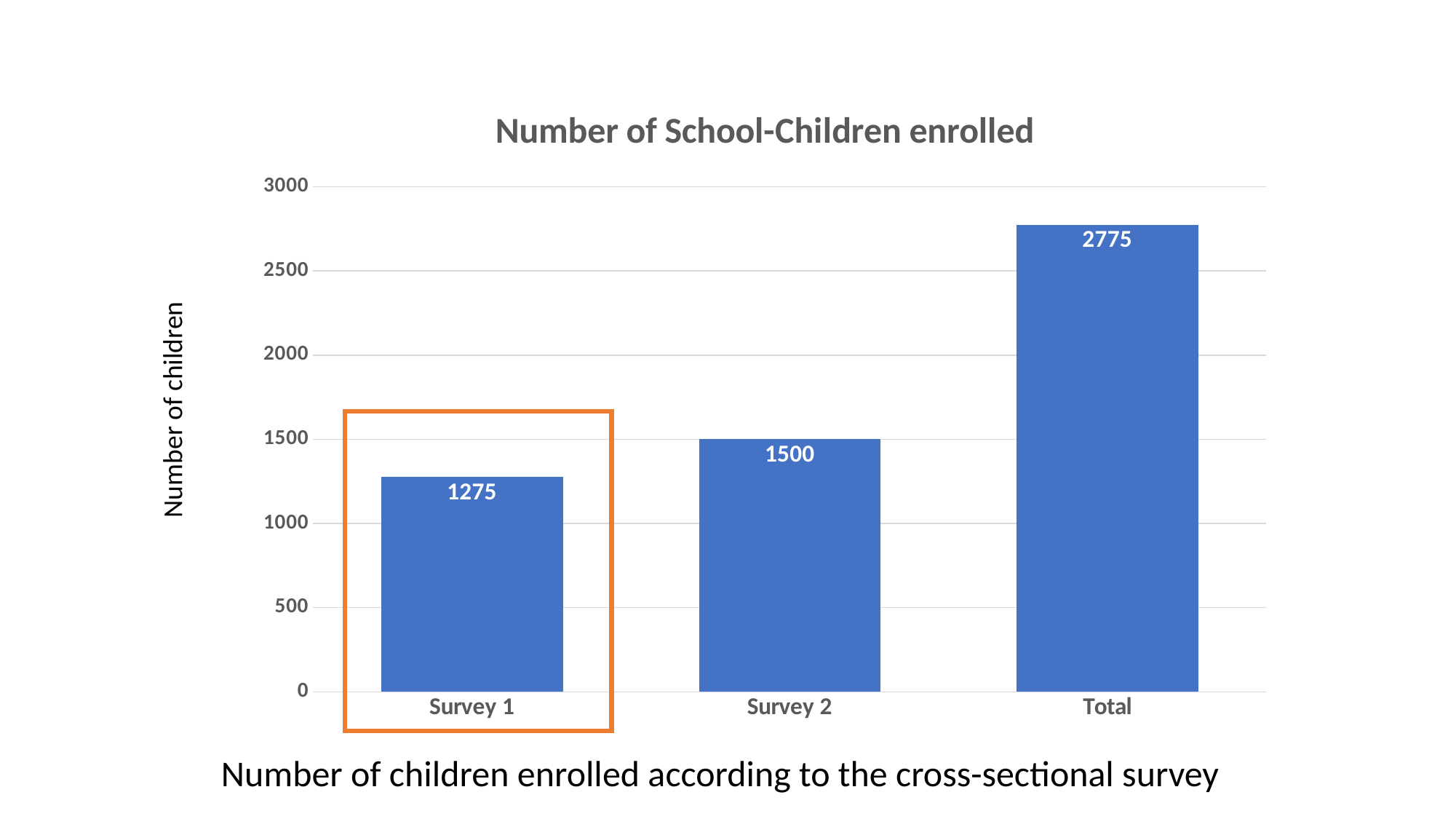
What is the difference between the values for Survey 2 and Survey 1? 225 What is the value for Survey 1? 1275 Which category is highlighted with an orange box? Survey 1 What is the value for Total? 2775 Which category has the lowest value? Survey 1 What is the title of the chart? Number of School-Children enrolled Is the value for Total greater or less than 2500? greater Which category has the highest value? Total What is the value for Survey 2? 1500 Which is larger, the value for Survey 1 or the value for Survey 2? Survey 2 How many categories are shown on the x axis? 3 What kind of chart is shown on the slide? bar chart